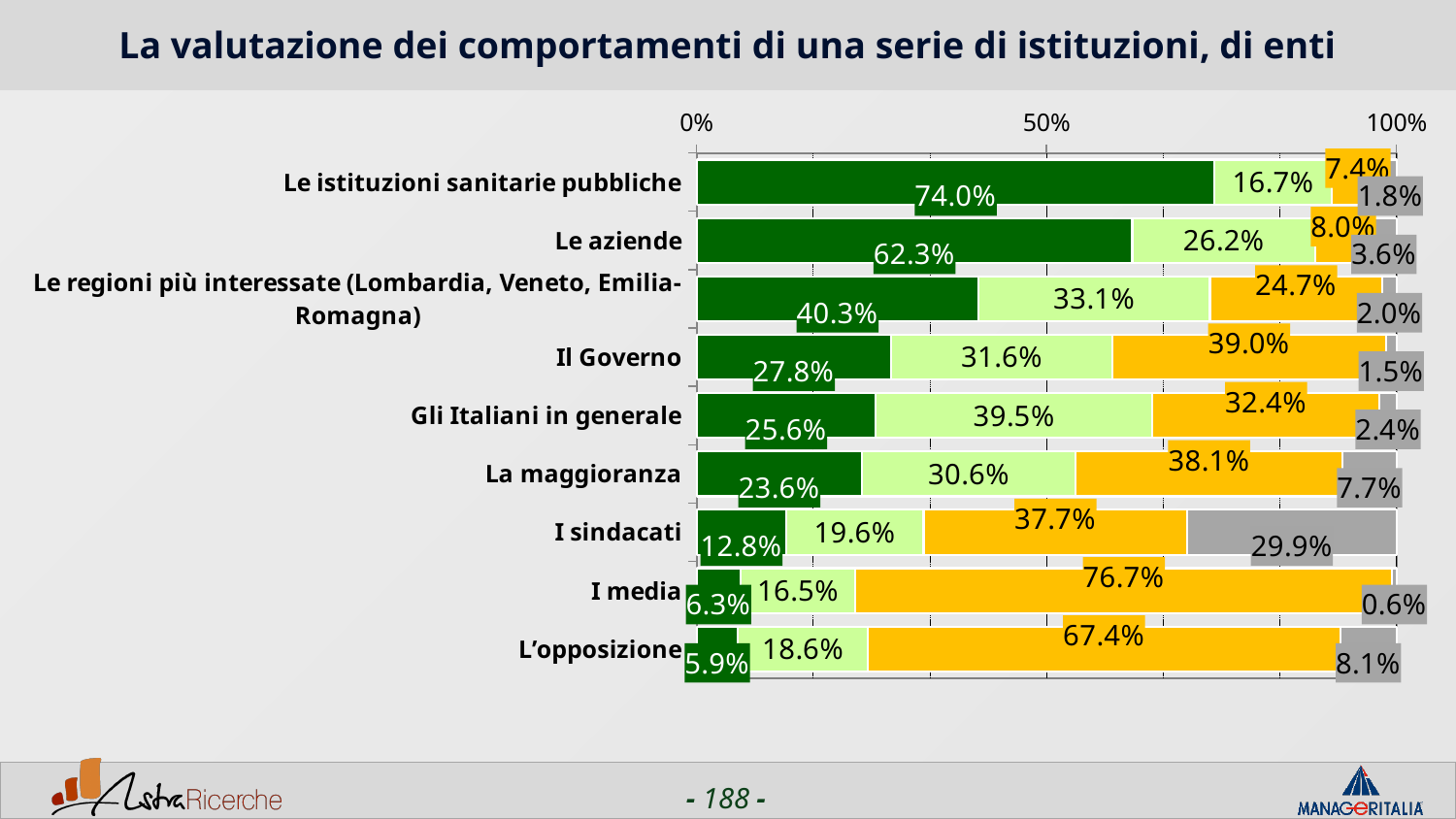
What is the value of the light green segment for "Gli Italiani in generale"? 39.5% Which category has the largest dark green segment? Le istituzioni sanitarie pubbliche Is the dark green value for "Le regioni più interessate (Lombardia, Veneto, Emilia-Romagna)" greater or less than 50%? less Which category has the smallest dark green segment? L’opposizione What kind of chart is shown on the slide? bar chart What is the value of the dark green segment for "Le aziende"? 62.3% What is the difference between the dark green values for "Il Governo" and "Gli Italiani in generale"? 2.2 percentage points What is the value of the gray segment for "I media"? 0.6% What is the total of the four segments for "I sindacati"? 100.0% How many institutions (categories) are listed on the chart? 9 What is the value of the orange segment for "I media"? 76.7% Which has a larger gray segment, "I sindacati" or "L’opposizione"? I sindacati